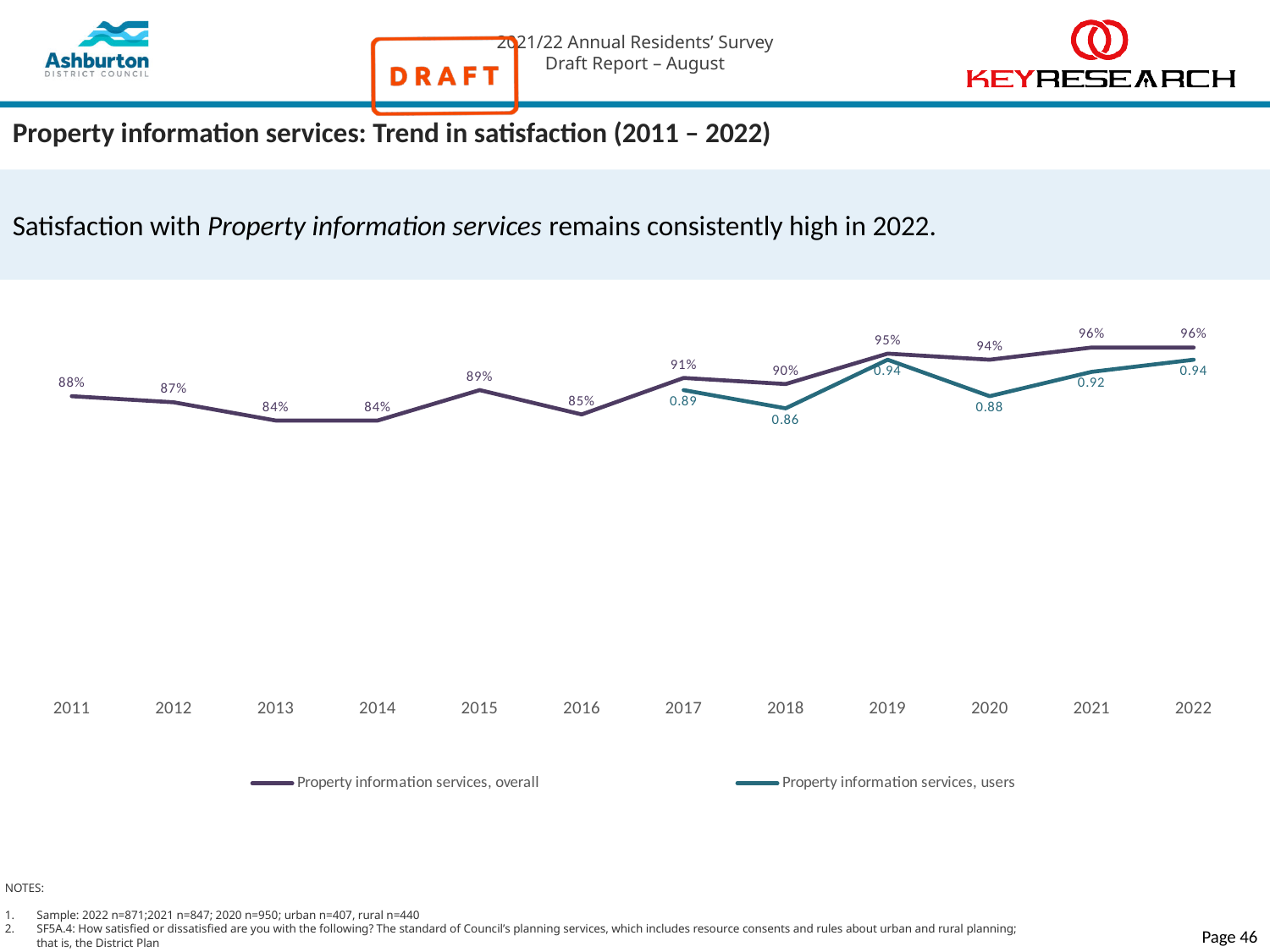
What is the value for Property information services, overall in 2011? 88% In which year is Property information services, users at its lowest? 2018 What is the value for Property information services, overall in 2019? 95% In which year is Property information services, overall at its lowest? 2013 and 2014 What is the value for Property information services, users in 2018? 0.86 Which is larger, the overall value in 2015 or the overall value in 2016? 2015 What is the difference between the overall values for 2022 and 2011? 8% Does the Property information services, overall line generally rise or fall from 2016 to 2022? rise How many years are shown on the x axis? 12 What is the title of the chart? Property information services: Trend in satisfaction (2011 – 2022) What kind of chart is shown on the slide? line chart How many series does the legend list? 2